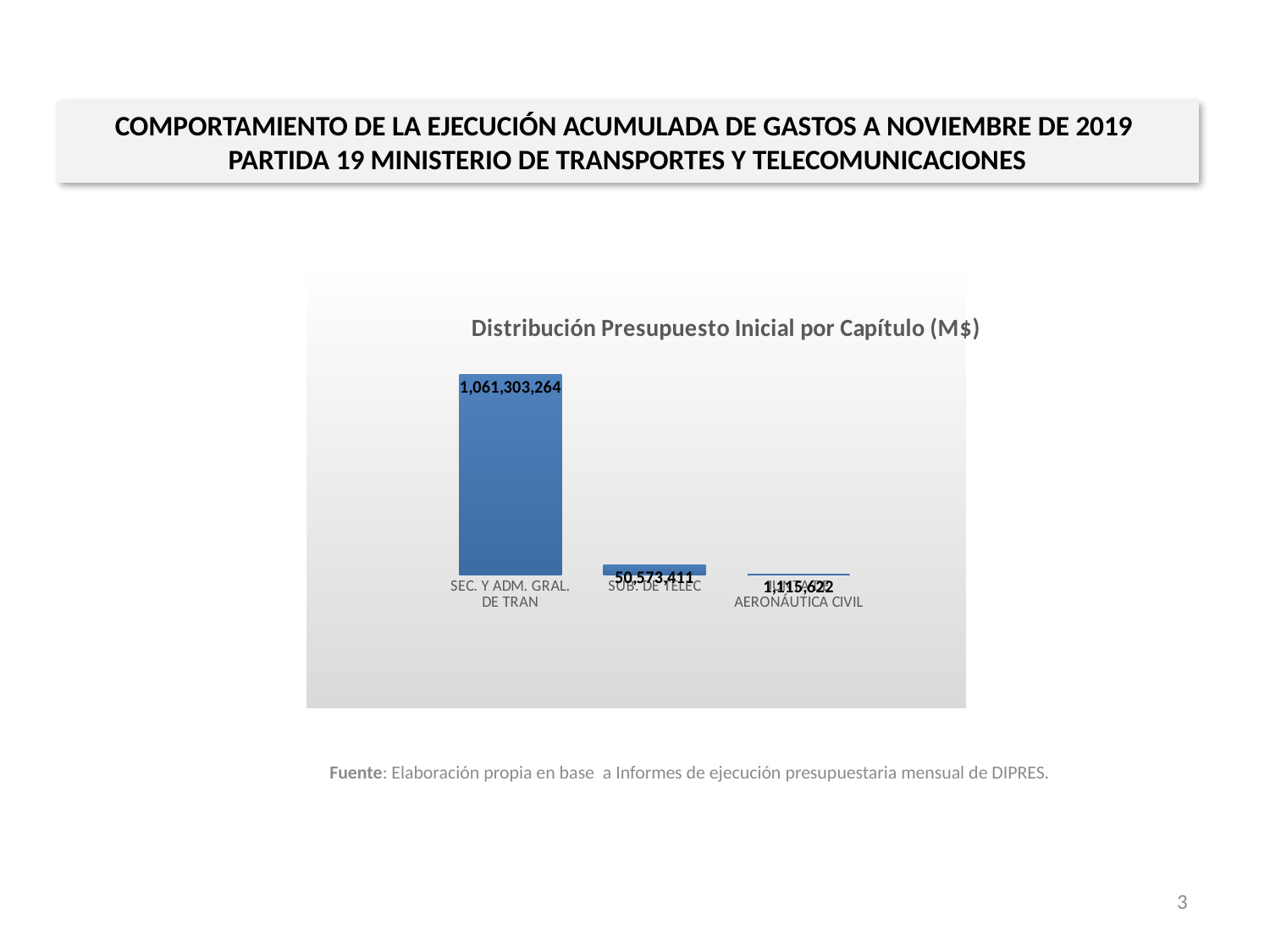
What is the difference between the values for SEC. Y ADM. GRAL. DE TRAN and SUB. DE TELEC? 1,010,729,853 Which category has the lowest value in the chart? AERONÁUTICA CIVIL What kind of chart is shown on the slide? Bar chart How many categories are shown in the chart? 3 What is the value for SUB. DE TELEC in the chart? 50,573,411 Which is larger, the value for SUB. DE TELEC or the value for AERONÁUTICA CIVIL? SUB. DE TELEC What is the value for SEC. Y ADM. GRAL. DE TRAN in the chart? 1,061,303,264 What is the value for AERONÁUTICA CIVIL in the chart? 1,115,622 What is the difference between the values for SUB. DE TELEC and AERONÁUTICA CIVIL? 49,457,789 Which category has the highest value in the chart? SEC. Y ADM. GRAL. DE TRAN What is the title of the chart? Distribución Presupuesto Inicial por Capítulo (M$) Do the values rise or fall from left to right across the categories? Fall